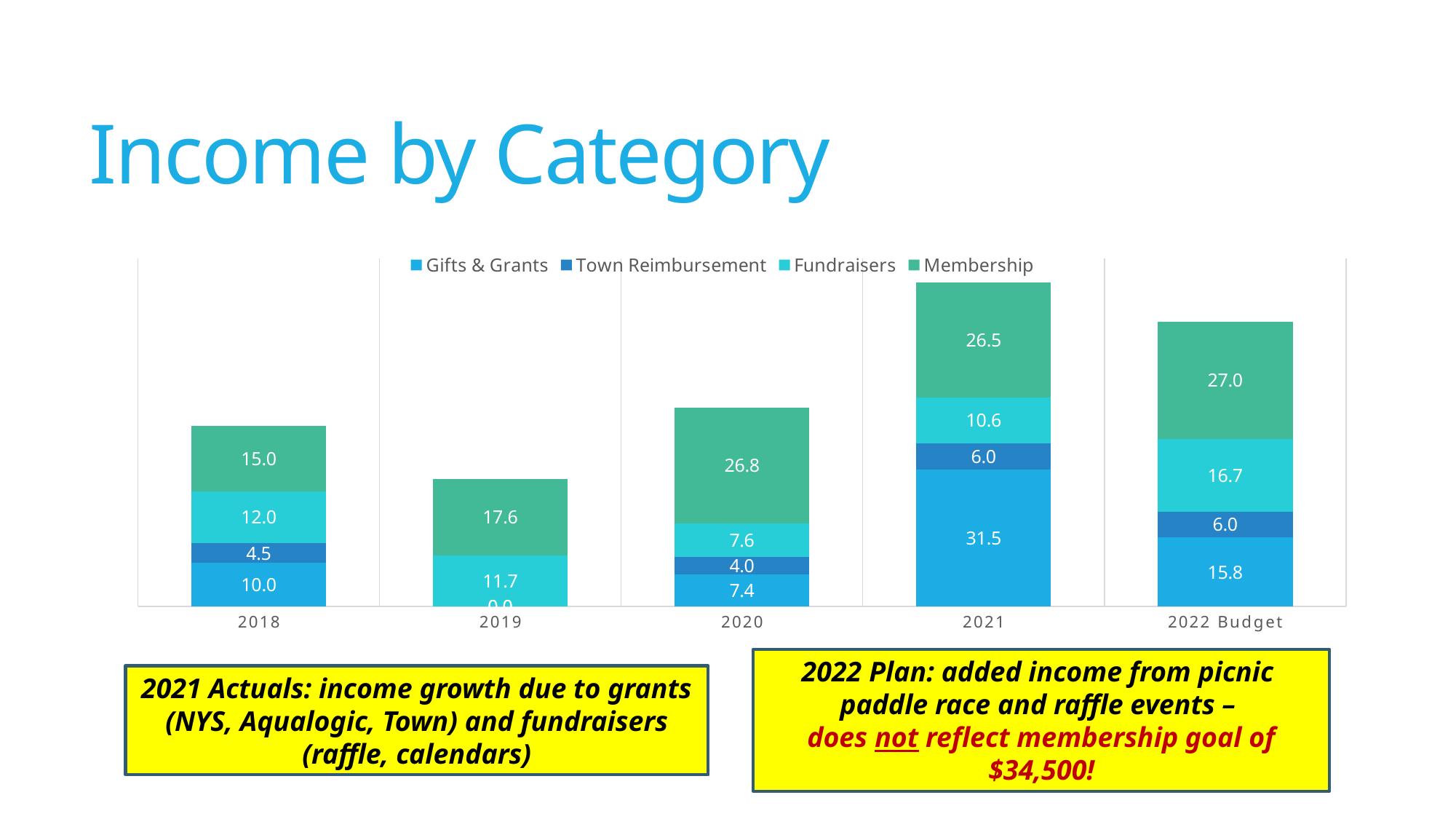
What is the difference between the Membership value for 2022 Budget and for 2021? 0.5 What is the Town Reimbursement value for 2020? 4.0 What is the Fundraisers value for 2018? 12.0 Which is larger, the Fundraisers value for 2020 or for 2021? 2021 Which year has the highest Gifts & Grants value? 2021 How many categories are shown on the x axis? 5 Which year has the lowest Membership value? 2018 What is the total of the stacked bar for 2021? 74.6 What kind of chart is shown on the slide? Stacked bar chart What is the Gifts & Grants value for 2022 Budget? 15.8 What is the Membership value for 2021? 26.5 How many series does the legend list? 4